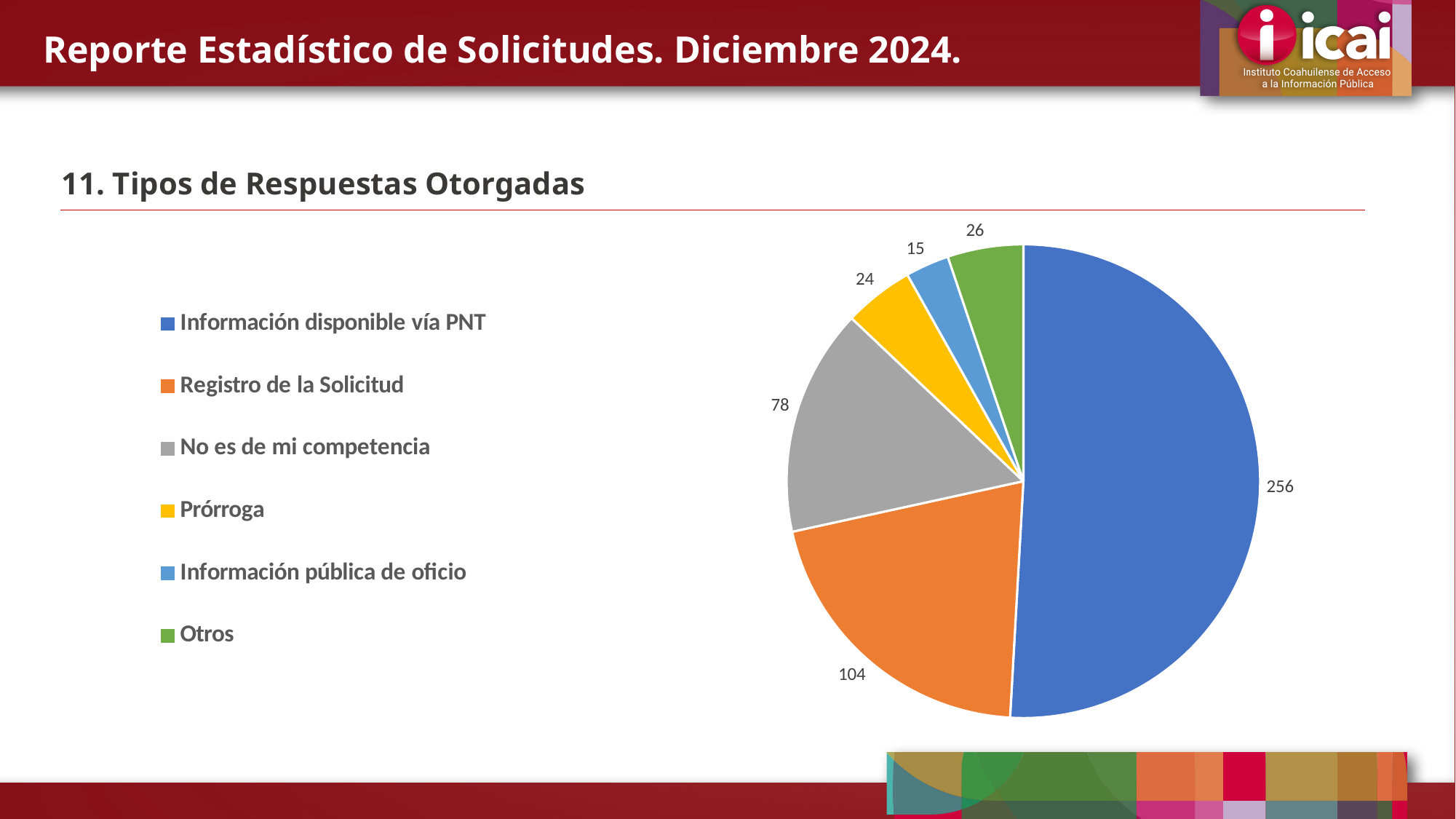
What is the value for Información pública de oficio? 15 What is the value for No es de mi competencia? 78 What is the value for Registro de la Solicitud? 104 What is the value for Prórroga? 24 Which is larger, Otros or Prórroga? Otros Which category has the largest slice? Información disponible vía PNT What is the total of all slices in the pie chart? 503 What is the value for Información disponible vía PNT? 256 What type of chart is shown on the slide? pie chart What is the difference between Registro de la Solicitud and No es de mi competencia? 26 Which category has the smallest slice? Información pública de oficio How many categories does the pie chart have? 6